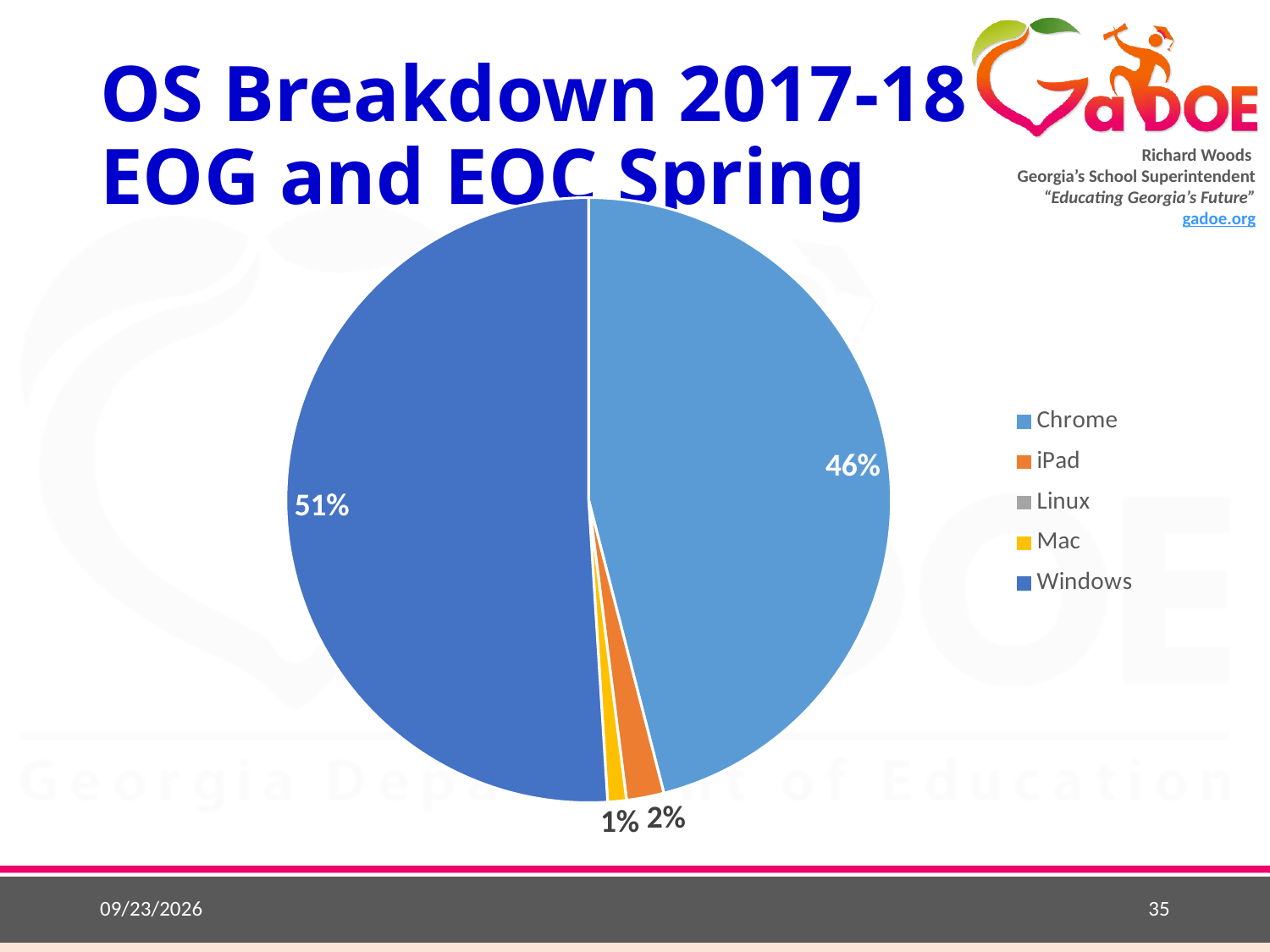
Which is larger, the Windows slice or the Chrome slice? Windows What kind of chart is shown on the slide? Pie chart What percentage of the pie is Windows? 51% What percentage of the pie is Chrome? 46% What share of the pie does iPad have? 2% What is the difference in percentage points between the Windows slice and the Chrome slice? 5 percentage points What share of the pie does Mac have? 1% What colour is used for the Windows slice in the legend? Dark blue Which is larger, the iPad slice or the Mac slice? iPad Which operating system has the largest slice of the pie? Windows How many entries does the legend list? 5 What is the title of the slide containing the chart? OS Breakdown 2017-18 EOG and EOC Spring